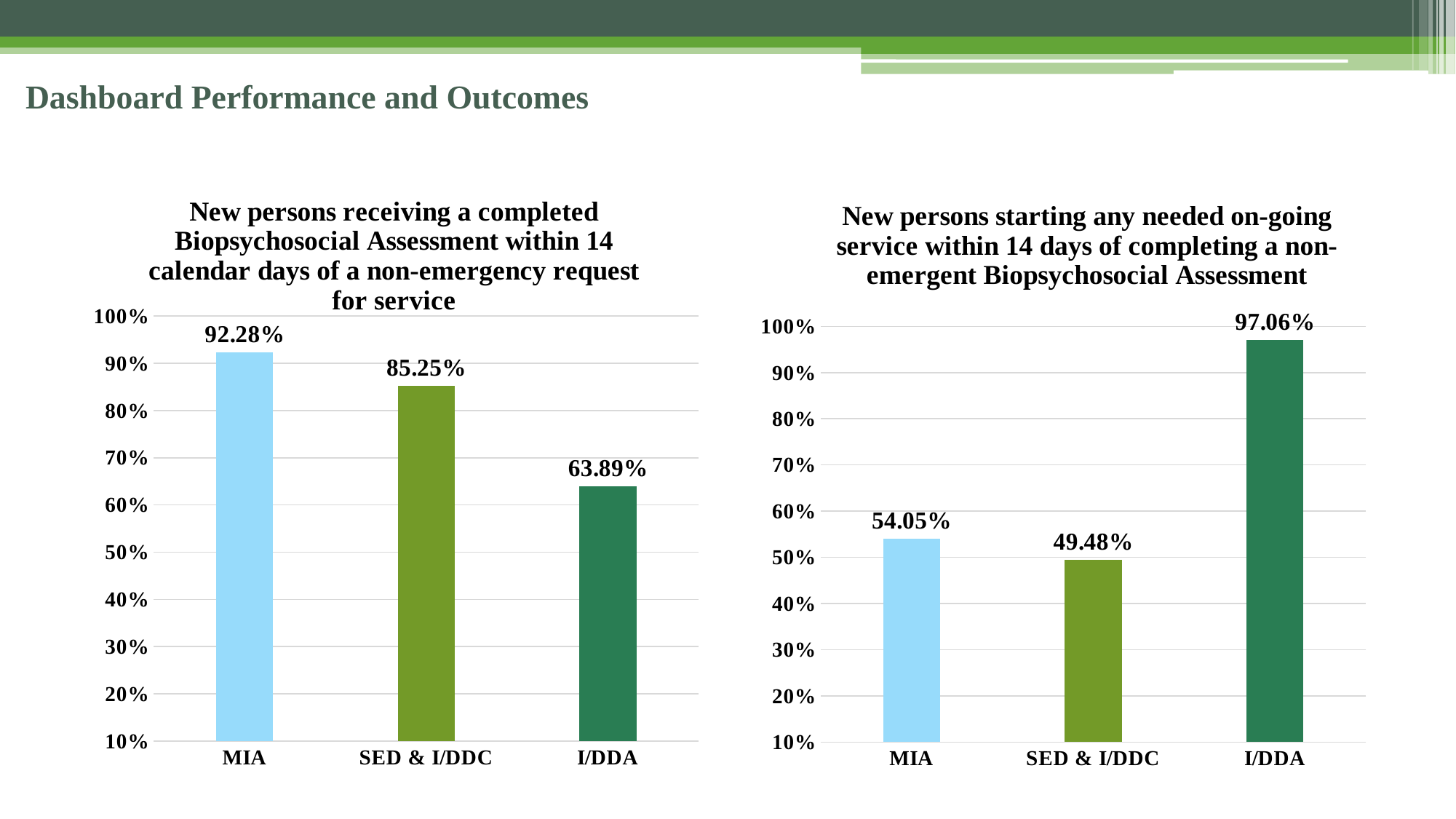
How many categories are shown in the right chart (starting on-going service within 14 days)? 3 In the left chart (Biopsychosocial Assessment within 14 calendar days), what is the value for MIA? 92.28% In the left chart (Biopsychosocial Assessment within 14 calendar days), do the values rise or fall from MIA to I/DDA? Fall In the right chart (starting on-going service within 14 days), which category has the highest value? I/DDA In the left chart (Biopsychosocial Assessment within 14 calendar days), what is the value for I/DDA? 63.89% In the right chart (starting on-going service within 14 days), what is the value for SED & I/DDC? 49.48% In the left chart (Biopsychosocial Assessment within 14 calendar days), is the value for I/DDA greater or less than 70%? less In the left chart (Biopsychosocial Assessment within 14 calendar days), which category has the lowest value? I/DDA What kind of chart is the left chart (Biopsychosocial Assessment within 14 calendar days)? Bar chart In the left chart (Biopsychosocial Assessment within 14 calendar days), what is the difference between the MIA and SED & I/DDC values? 7.03% In the right chart (starting on-going service within 14 days), what is the difference between the I/DDA and MIA values? 43.01% In the right chart (starting on-going service within 14 days), which is larger, the value for MIA or for SED & I/DDC? MIA